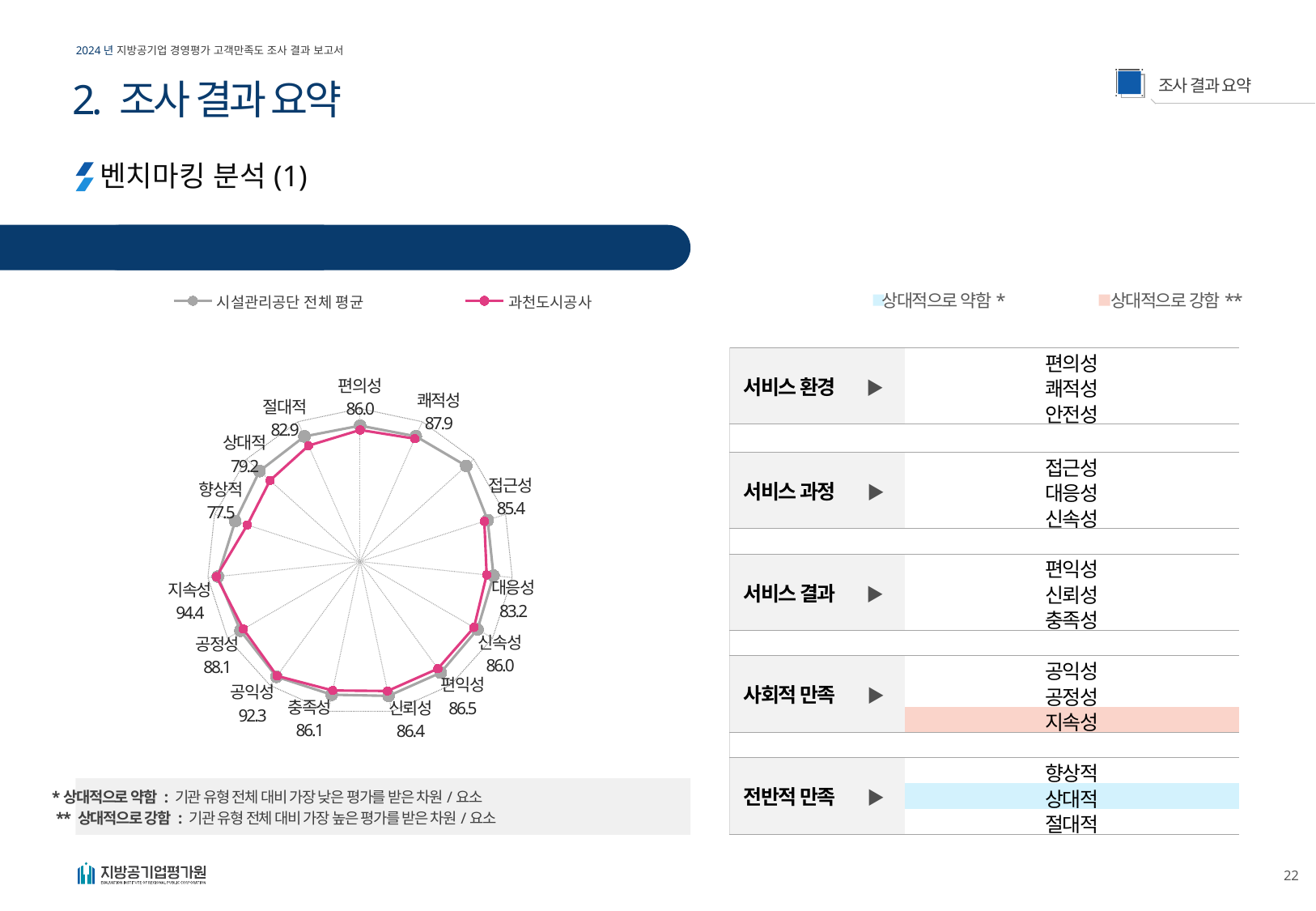
What is the difference between the labelled values for 지속성 and 향상적? 16.9 Which has the larger labelled value, 쾌적성 or 편의성? 쾌적성 What value is labelled for 쾌적성 on the radar chart? 87.9 Which series is plotted in pink on the radar chart? 과천도시공사 How many categories (axes) does the radar chart have? 15 What value is labelled for 공익성 on the radar chart? 92.3 What value is labelled for 지속성 on the radar chart? 94.4 Which category has the highest labelled value on the radar chart? 지속성 How many series does the chart legend list? 2 Which category has the lowest labelled value on the radar chart? 향상적 What kind of chart is shown on the slide? radar chart What value is labelled for 향상적 on the radar chart? 77.5